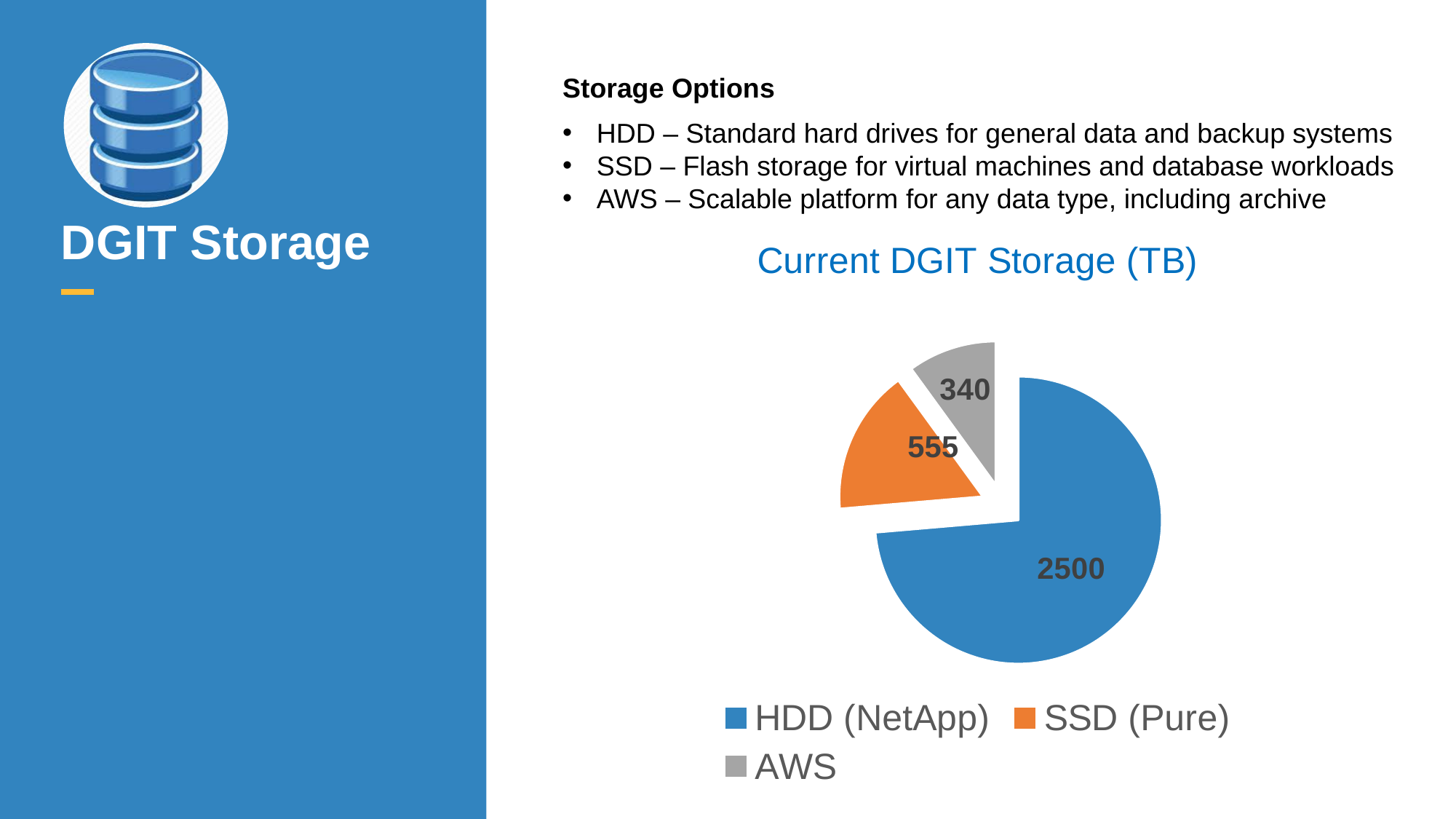
What is the value for SSD (Pure) in the pie chart? 555 What is the difference between the SSD (Pure) value and the AWS value? 215 Which is larger, the value for SSD (Pure) or the value for AWS? SSD (Pure) What is the difference between the HDD (NetApp) value and the SSD (Pure) value? 1945 What is the total of all slices in the pie chart? 3395 Which category has the largest slice in the pie chart? HDD (NetApp) What is the title of the chart? Current DGIT Storage (TB) What is the value for HDD (NetApp) in the pie chart? 2500 Which category has the smallest slice in the pie chart? AWS What is the value for AWS in the pie chart? 340 What type of chart is shown on the slide? Pie chart How many categories are shown in the pie chart? 3